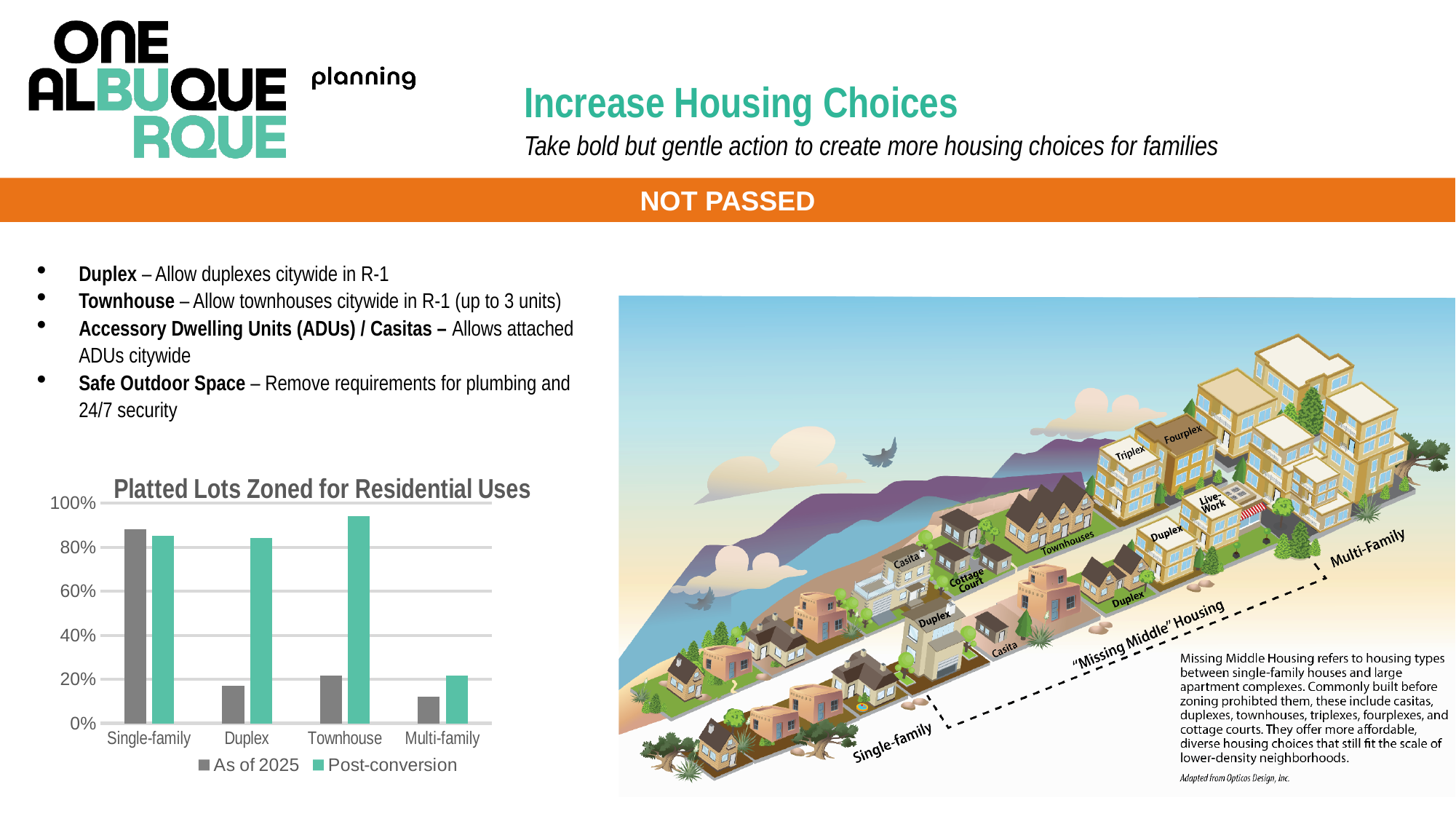
How many categories are shown on the x axis of the chart? 4 Which category has the lowest Post-conversion value? Multi-family Is the Post-conversion value for Townhouse greater or less than 80%? greater Is the As of 2025 value for Duplex greater or less than 20%? less What is the title of the chart? Platted Lots Zoned for Residential Uses Which series is shown in gray in the chart? As of 2025 Which category has the lowest As of 2025 value? Multi-family Which category has the highest As of 2025 value? Single-family How many series does the chart legend list? 2 What kind of chart is shown on the slide? bar chart Which category has the highest Post-conversion value? Townhouse For Duplex, which is larger: the As of 2025 value or the Post-conversion value? Post-conversion